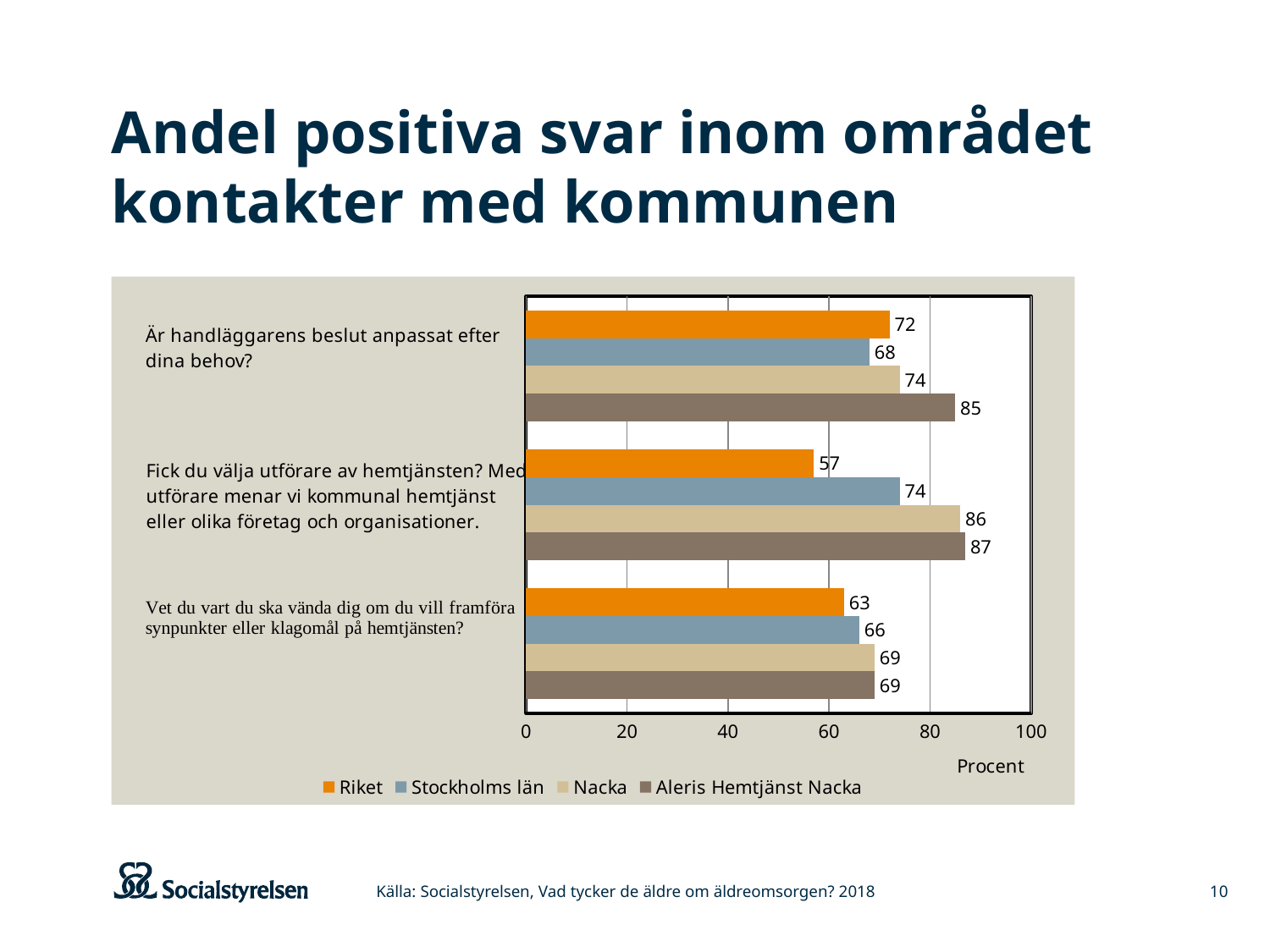
What is the value for Nacka on the question "Fick du välja utförare av hemtjänsten?"? 86 Which is larger on the question "Fick du välja utförare av hemtjänsten?": Stockholms län or Riket? Stockholms län Which series has the highest value on the question "Är handläggarens beslut anpassat efter dina behov?"? Aleris Hemtjänst Nacka Which series has the lowest value on the question "Fick du välja utförare av hemtjänsten?"? Riket What is the difference between Aleris Hemtjänst Nacka and Riket on the question "Är handläggarens beslut anpassat efter dina behov?"? 13 What is the value for Aleris Hemtjänst Nacka on the question "Är handläggarens beslut anpassat efter dina behov?"? 85 How many question categories are shown on the chart? 3 How many series does the legend list? 4 What kind of chart is shown on the slide? Bar chart What is the value for Riket on the question "Fick du välja utförare av hemtjänsten?"? 57 What unit is shown on the horizontal axis of the chart? Procent What is the value for Stockholms län on the question "Vet du vart du ska vända dig om du vill framföra synpunkter eller klagomål på hemtjänsten?"? 66